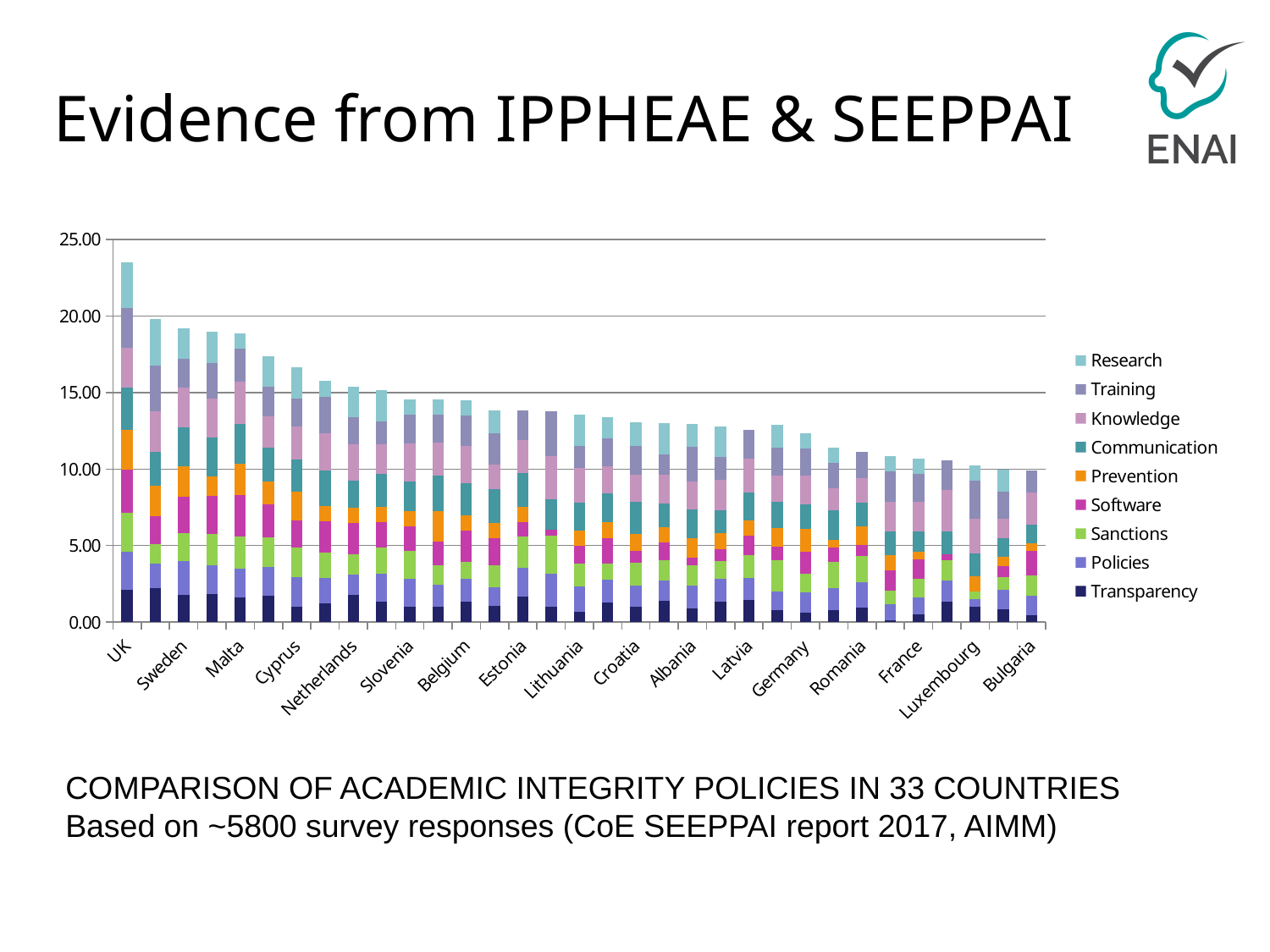
Is the total value for Germany greater or less than 10? greater Which series is listed first (at the top) in the legend? Research Which country has the highest total bar? UK Do the total bar heights rise or fall from left to right along the x axis? fall How many countries (bars) are plotted in the chart? 33 How many series does the legend list? 9 What kind of chart is shown on the slide? stacked bar chart Is the total value for Malta greater or less than 20? less Is the total value for Croatia greater or less than 15? less Which has the larger total bar, Malta or Germany? Malta